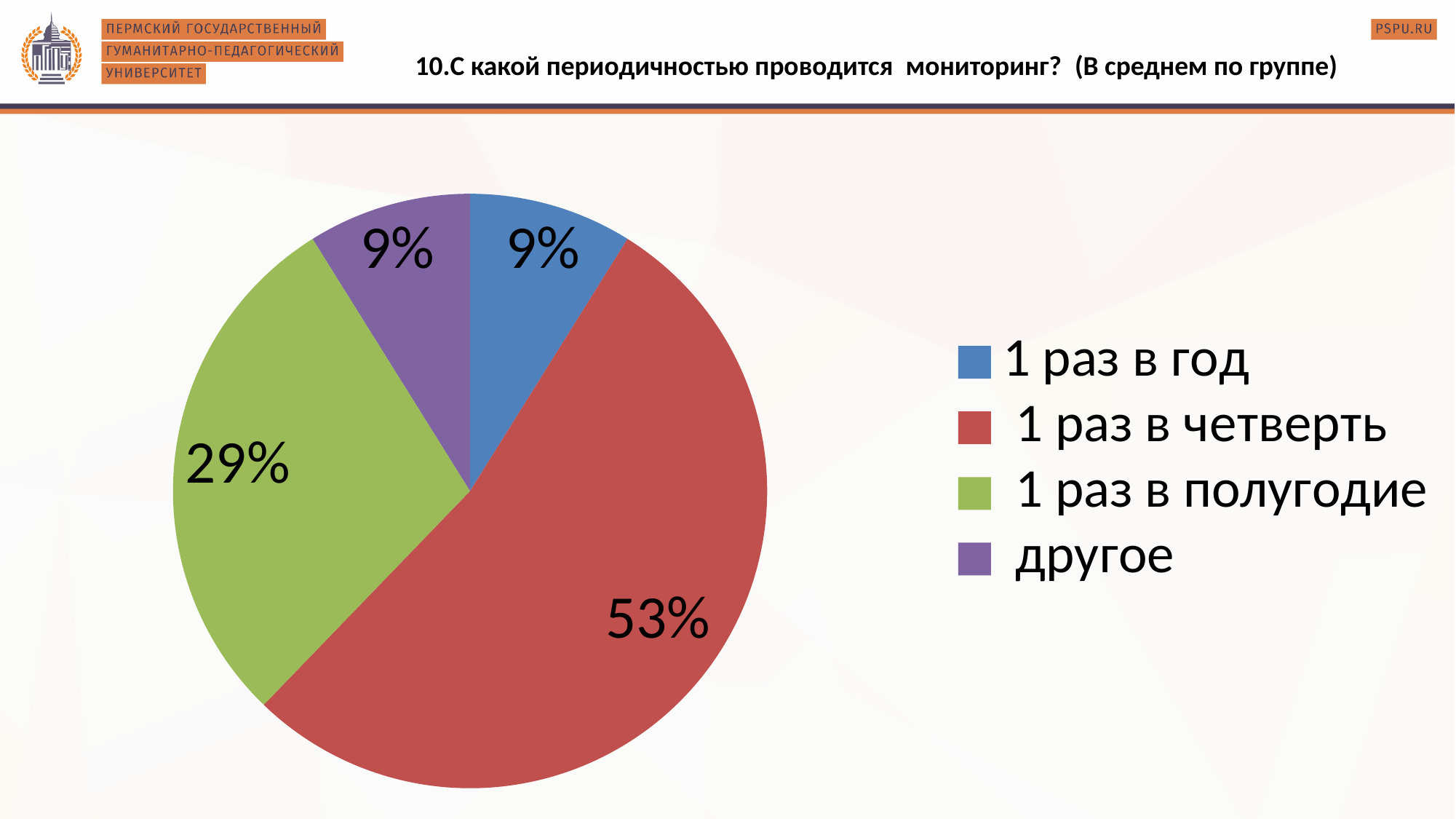
What kind of chart is shown on the slide? Pie chart Which legend entry is shown in purple? другое What colour is the slice for "1 раз в четверть"? Red What share of the pie does "другое" have? 9% What is the difference between the shares of "1 раз в четверть" and "1 раз в полугодие"? 24% What share of the pie does "1 раз в полугодие" have? 29% What is the difference between the shares of "1 раз в полугодие" and "другое"? 20% How many categories does the pie chart show? 4 Which is larger, the share of "1 раз в полугодие" or the share of "1 раз в год"? 1 раз в полугодие Which category has the largest slice of the pie? 1 раз в четверть What share of the pie does "1 раз в год" have? 9% What share of the pie does "1 раз в четверть" have? 53%